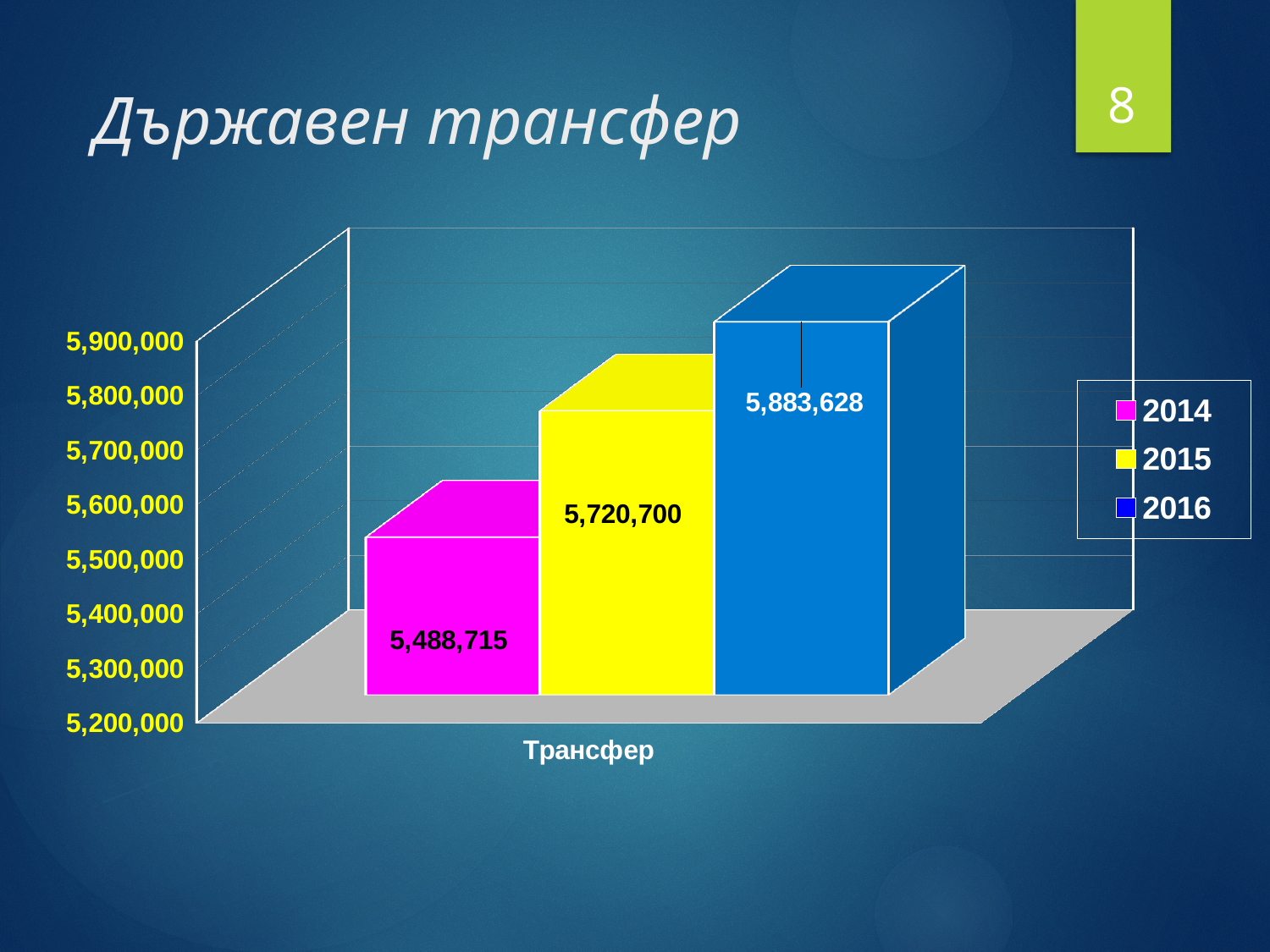
What is the title of the slide containing the chart? Държавен трансфер Is the value for 2016 greater or less than 5,800,000? greater What is the value for 2014 in the chart? 5,488,715 What kind of chart is shown on the slide? bar chart How many series does the legend list? 3 What is the difference between the values for 2015 and 2014? 231,985 Which year has the highest value in the chart? 2016 Which is larger, the value for 2014 or the value for 2015? 2015 What is the difference between the values for 2016 and 2015? 162,928 What is the value for 2015 in the chart? 5,720,700 What is the value for 2016 in the chart? 5,883,628 Which year has the lowest value in the chart? 2014